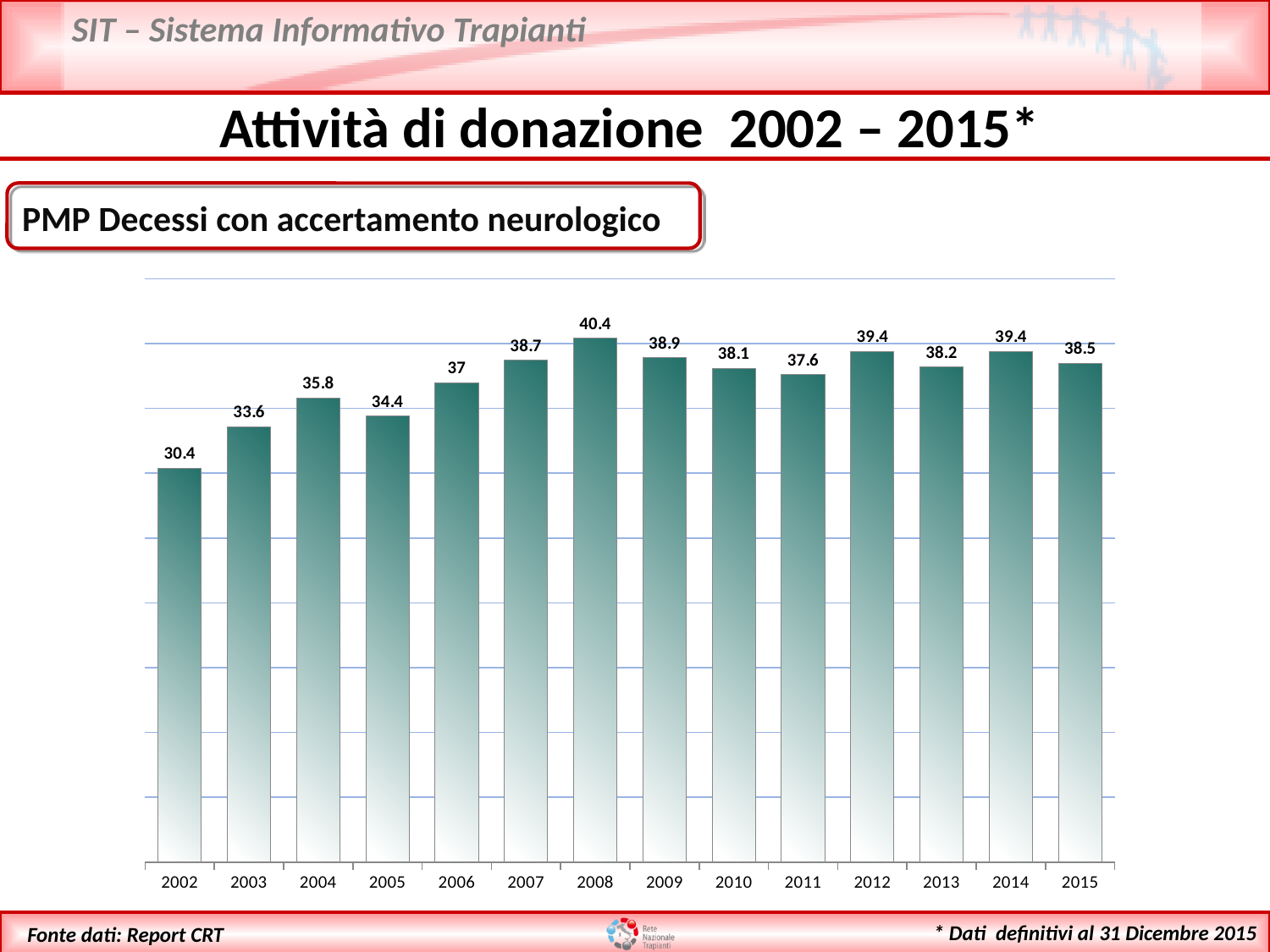
What kind of chart is this? bar chart What is the value for 2002? 30.4 What is the value for 2015? 38.5 What is the difference between the values for 2015 and 2014? 0.9 Which is larger, the value for 2006 or the value for 2007? 2007 What is the value for 2008? 40.4 Do the values rise or fall from 2002 to 2008? rise What is the difference between the values for 2008 and 2002? 10 What is the value for 2011? 37.6 Which year has the lowest value? 2002 Which year has the highest value? 2008 How many years are shown on the x axis? 14